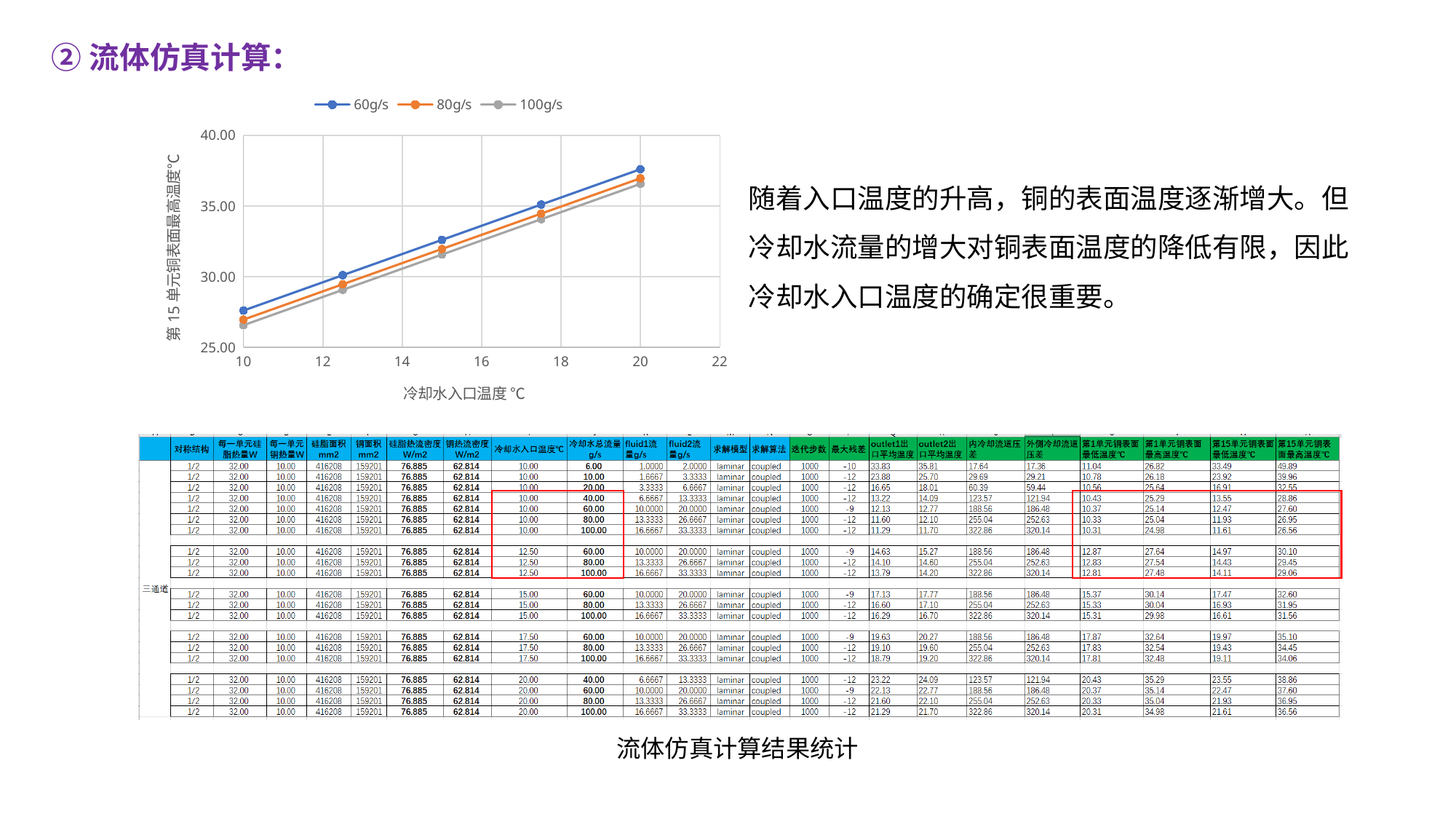
Is the value for the 100g/s series at an inlet temperature of 10 greater or less than 30.00? less What is the title of the chart's x axis? 冷却水入口温度 °C What are the series names listed in the chart's legend? 60g/s, 80g/s, 100g/s Which series has the highest value at an inlet temperature of 20? 60g/s At an inlet temperature of 20, which series has the larger value, 60g/s or 100g/s? 60g/s Is the value for the 60g/s series at an inlet temperature of 20 greater or less than 35.00? greater How many data points are plotted for the 60g/s series? 5 Which series has the lowest value at an inlet temperature of 10? 100g/s Do the values of the 80g/s series rise or fall as the inlet temperature increases along the x axis? rise Is the value for the 80g/s series at an inlet temperature of 15 greater or less than 30.00? greater How many series does the chart's legend list? 3 What kind of chart is shown on the slide? line chart